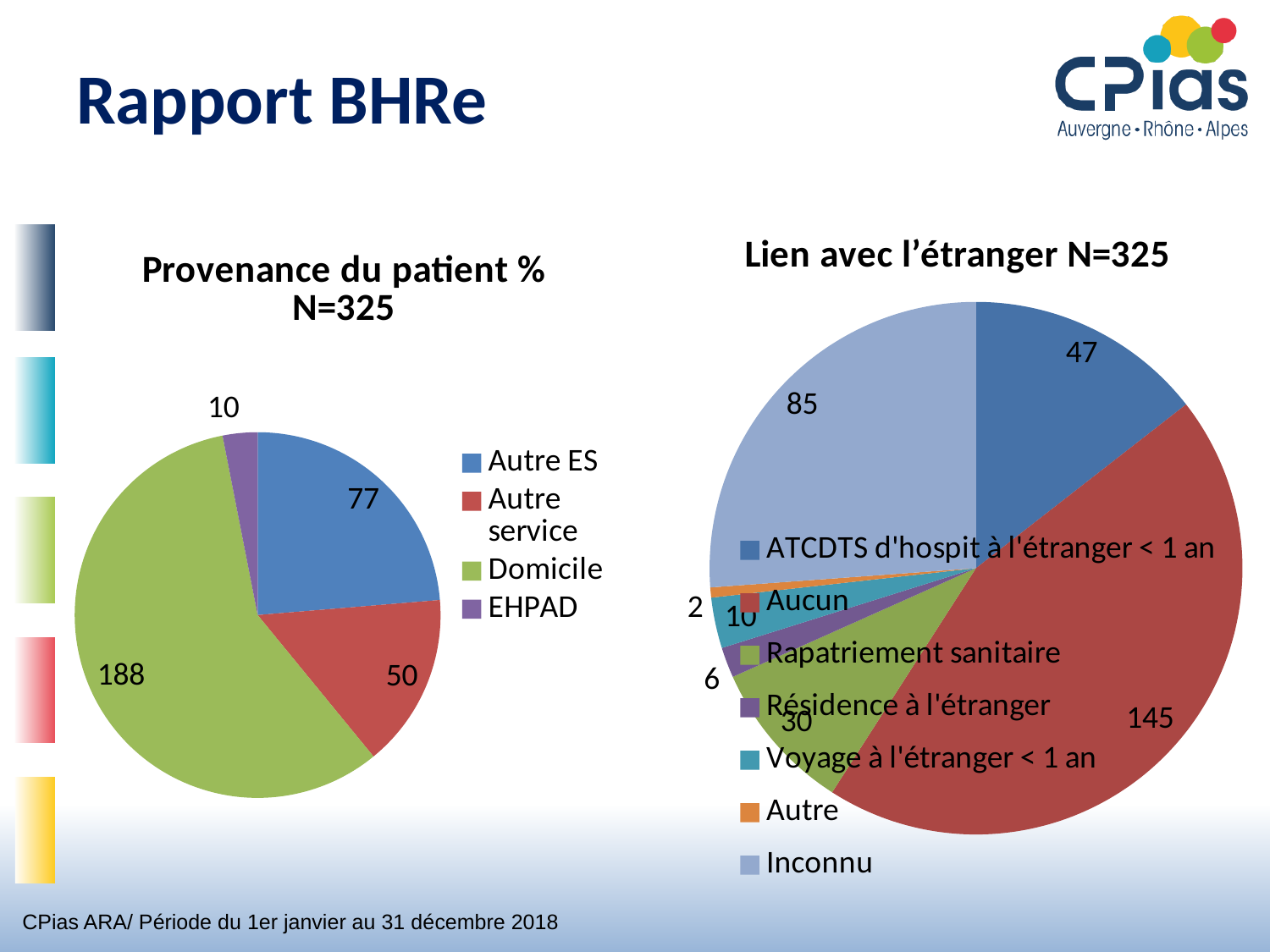
In the 'Lien avec l'étranger N=325' chart, which category has the largest slice? Aucun In the 'Lien avec l'étranger N=325' chart, which is larger: Rapatriement sanitaire or Voyage à l'étranger < 1 an? Rapatriement sanitaire In the 'Provenance du patient % N=325' chart, how many categories does the legend list? 4 In the 'Provenance du patient % N=325' chart, what is the value for Autre ES? 77 In the 'Provenance du patient % N=325' chart, which category has the smallest slice? EHPAD In the 'Lien avec l'étranger N=325' chart, what is the difference between Inconnu and ATCDTS d'hospit à l'étranger < 1 an? 38 In the 'Lien avec l'étranger N=325' chart, how many categories does the legend list? 7 In the 'Lien avec l'étranger N=325' chart, what is the value for Aucun? 145 In the 'Provenance du patient % N=325' chart, what is the difference between Autre ES and Autre service? 27 What kind of chart is 'Lien avec l'étranger N=325'? Pie chart In the 'Provenance du patient % N=325' chart, what is the value for Domicile? 188 In the 'Lien avec l'étranger N=325' chart, what is the value for Inconnu? 85